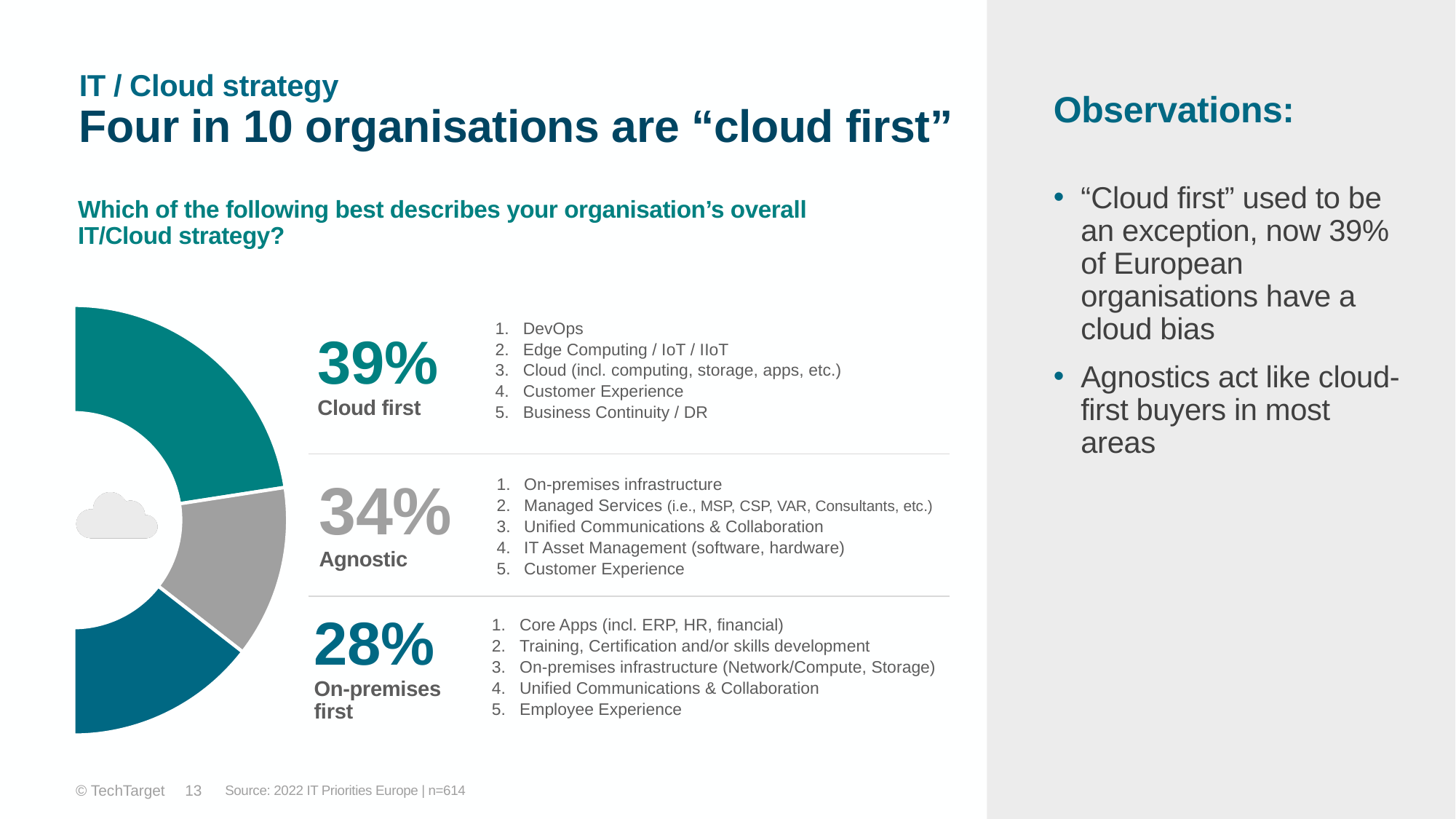
What percentage of organisations are "Agnostic" in their IT/Cloud strategy? 34% What percentage of organisations describe their IT/Cloud strategy as "Cloud first"? 39% What percentage of organisations are "On-premises first"? 28% What is the difference in percentage points between "Cloud first" and "On-premises first"? 11 Which IT/Cloud strategy category has the highest share? Cloud first What colour is the "Agnostic" segment of the chart? Grey What is the difference in percentage points between "Cloud first" and "Agnostic"? 5 Which is larger, the share for "Agnostic" or the share for "On-premises first"? Agnostic Which IT/Cloud strategy category has the lowest share? On-premises first What is the sample size (n) given in the source note for the chart? 614 What kind of chart is used to show the IT/Cloud strategy breakdown? Pie chart (donut) How many IT/Cloud strategy categories are shown in the chart? 3